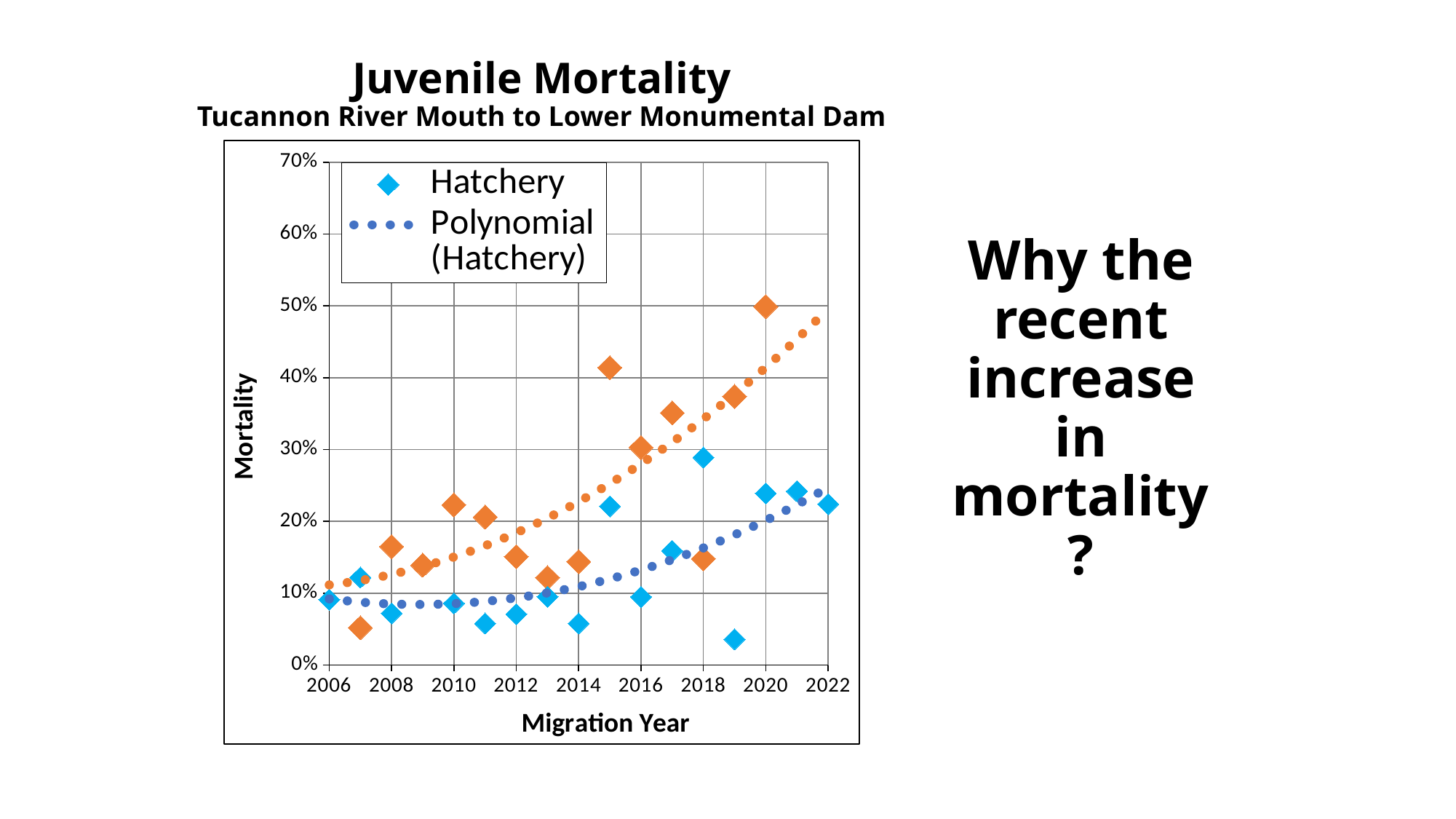
What is the title of the chart? Juvenile Mortality In which migration year is the Hatchery mortality highest? 2018 Does the Polynomial (Hatchery) trendline rise or fall from 2006 to 2022? rise What kind of chart is shown on the slide? scatter chart Which year has the higher Hatchery mortality, 2015 or 2016? 2015 Is the Hatchery mortality for 2008 greater or less than 10%? less Is the Hatchery mortality for 2018 greater or less than 20%? greater In which migration year is the Hatchery mortality lowest? 2019 Is the Hatchery mortality for 2019 greater or less than 10%? less How many entries does the chart legend list? 2 What is the label of the x axis? Migration Year